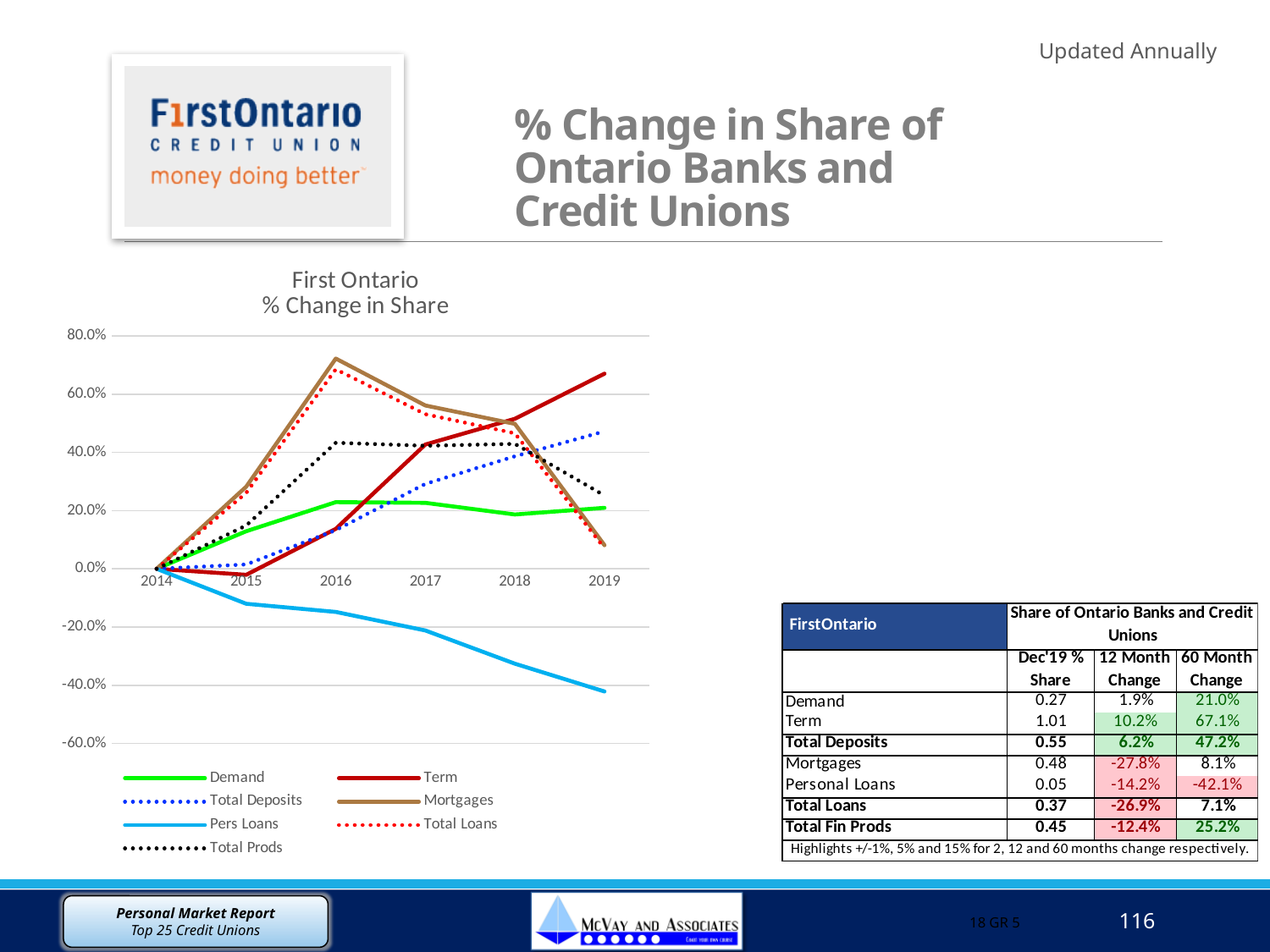
Which series has the highest value in 2019? Term In 2019, which is larger: the value for Term or the value for Mortgages? Term What is the title of the chart? First Ontario % Change in Share Does the Pers Loans series rise or fall from 2014 to 2019? fall Which series has the highest value in 2016? Mortgages Is the value for Pers Loans in 2019 greater or less than -20.0%? less How many series does the chart legend list? 7 Which series has the lowest value in 2019? Pers Loans Is the value for Demand in 2019 greater or less than 40.0%? less Is the value for Mortgages in 2016 greater or less than 60.0%? greater What kind of chart is shown on the slide? line chart How many years are plotted along the x axis of the chart? 6